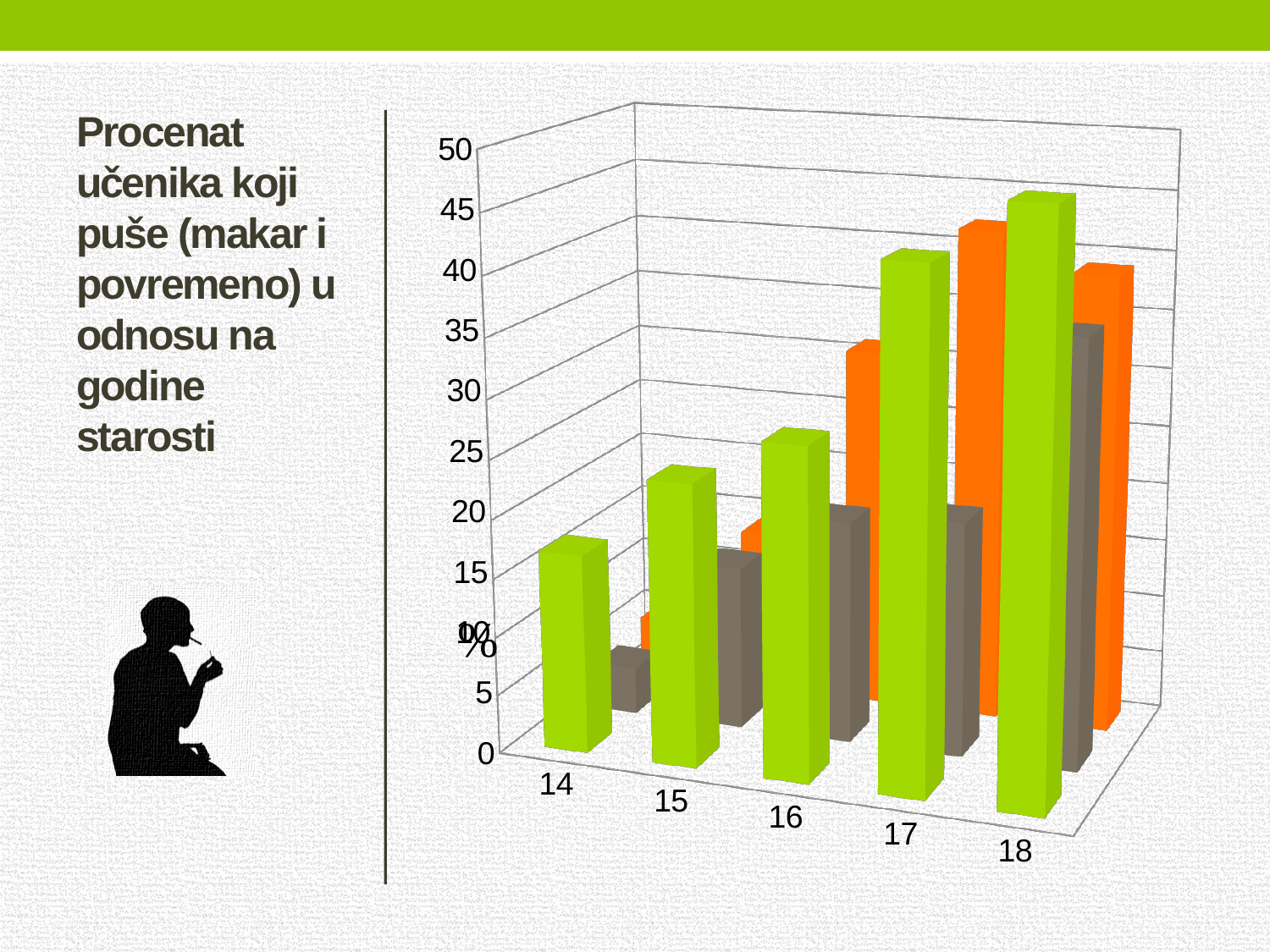
How many bars are plotted for each age category in the chart? 3 Is the green bar for age 18 greater or less than 40? greater Is the gray bar for age 14 greater or less than 10? less Which is taller for age 17: the green bar or the gray bar? green bar Is the orange bar for age 16 greater or less than 25? greater Which age has the shortest green bar in the chart? 14 Which age has the tallest green bar in the chart? 18 What kind of chart is shown on the slide? bar chart What unit label is shown on the vertical axis of the chart? % Do the green bars rise or fall as age increases from 14 to 18? rise How many age categories are shown on the x axis of the chart? 5